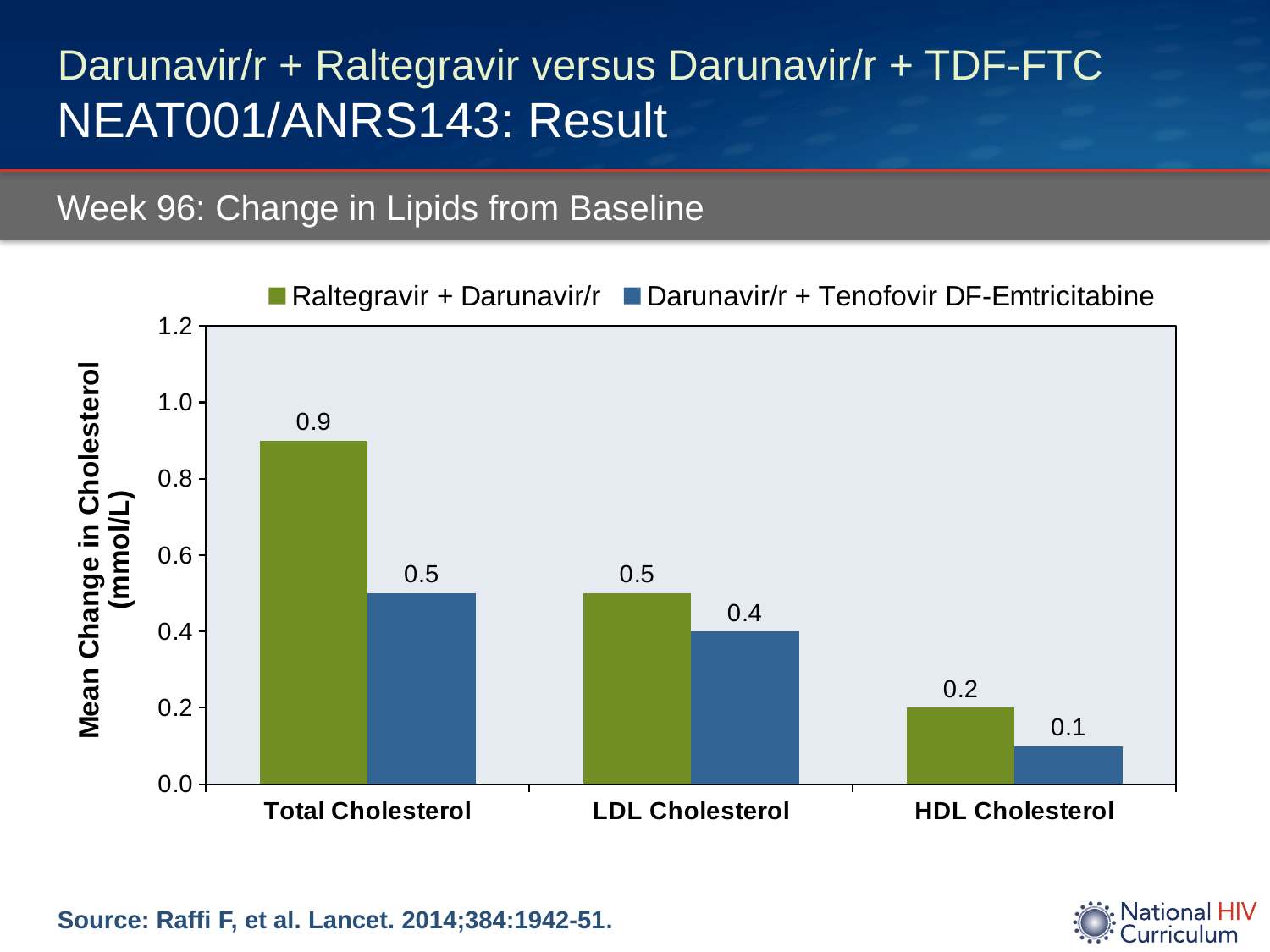
How many series does the legend list? 2 What is the mean change in Total Cholesterol for Raltegravir + Darunavir/r? 0.9 What kind of chart is shown on the slide? Bar chart What is the difference between the two series for Total Cholesterol? 0.4 Which category has the highest value for Raltegravir + Darunavir/r? Total Cholesterol What is the mean change in HDL Cholesterol for Raltegravir + Darunavir/r? 0.2 What is the mean change in LDL Cholesterol for Darunavir/r + Tenofovir DF-Emtricitabine? 0.4 How many categories are shown on the x axis? 3 For LDL Cholesterol, which series has the larger value? Raltegravir + Darunavir/r Is the value for Total Cholesterol in the Darunavir/r + Tenofovir DF-Emtricitabine series greater or less than 0.6? less Which category has the lowest value for Darunavir/r + Tenofovir DF-Emtricitabine? HDL Cholesterol What is the y-axis label of the chart? Mean Change in Cholesterol (mmol/L)